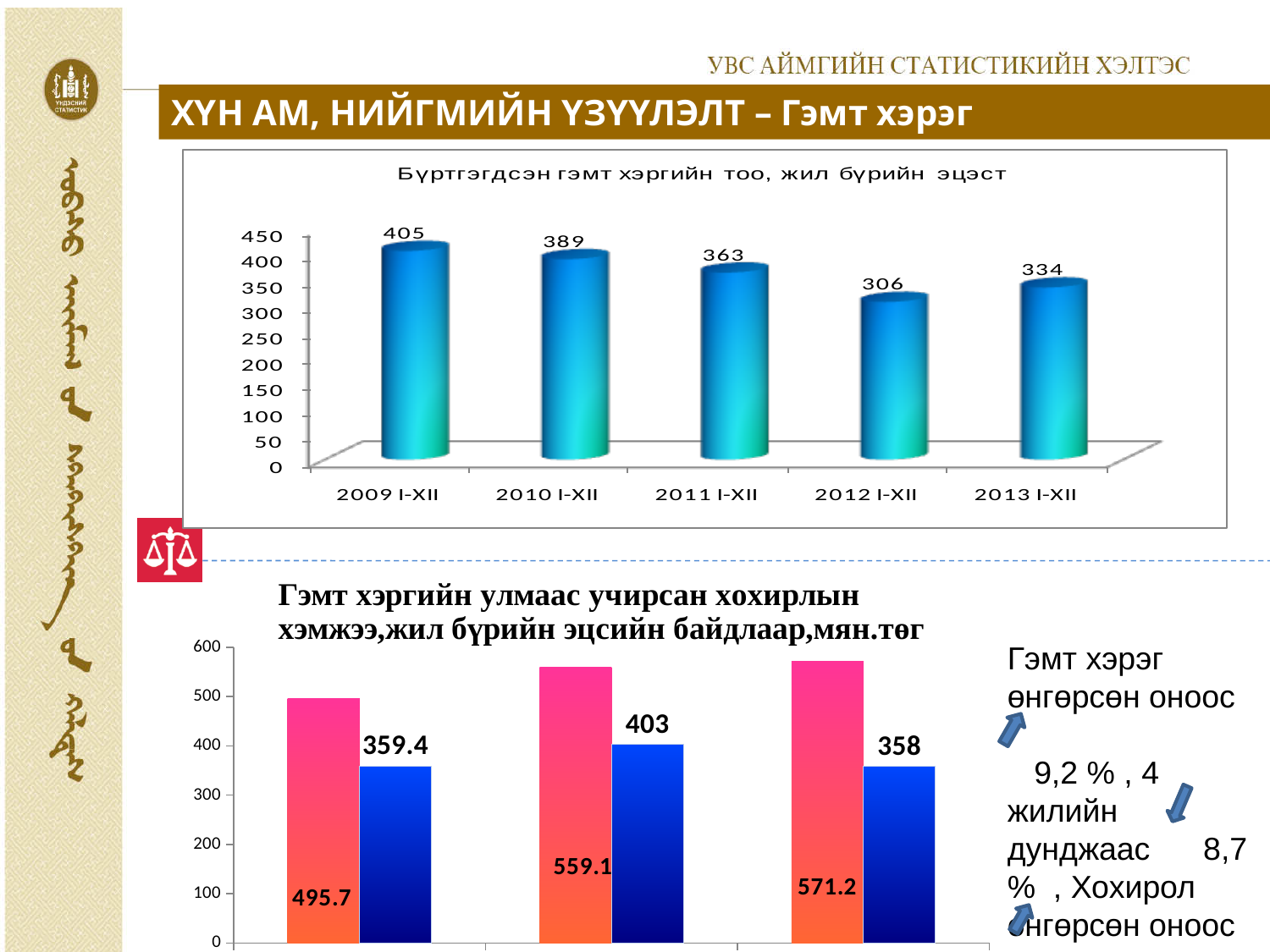
In the top chart 'Бүртгэгдсэн гэмт хэргийн тоо, жил бүрийн эцэст', what is the value for 2009 I-XII? 405 In the top chart 'Бүртгэгдсэн гэмт хэргийн тоо, жил бүрийн эцэст', which is larger: the value for 2013 I-XII or 2012 I-XII? 2013 I-XII In the bottom chart 'Гэмт хэргийн улмаас учирсан хохирлын хэмжээ', what is the value of the red bar in the first group from the left? 495.7 In the top chart 'Бүртгэгдсэн гэмт хэргийн тоо, жил бүрийн эцэст', how many years are shown on the x axis? 5 In the top chart 'Бүртгэгдсэн гэмт хэргийн тоо, жил бүрийн эцэст', what is the value for 2012 I-XII? 306 What kind of chart is the top chart 'Бүртгэгдсэн гэмт хэргийн тоо, жил бүрийн эцэст'? bar chart In the top chart 'Бүртгэгдсэн гэмт хэргийн тоо, жил бүрийн эцэст', which year has the highest value? 2009 I-XII In the bottom chart 'Гэмт хэргийн улмаас учирсан хохирлын хэмжээ', what is the value of the blue bar in the middle group? 403 In the top chart 'Бүртгэгдсэн гэмт хэргийн тоо, жил бүрийн эцэст', what is the difference between the values for 2010 I-XII and 2011 I-XII? 26 In the bottom chart 'Гэмт хэргийн улмаас учирсан хохирлын хэмжээ', what is the difference between the red and blue bars in the rightmost group? 213.2 In the top chart 'Бүртгэгдсэн гэмт хэргийн тоо, жил бүрийн эцэст', do the values rise or fall from 2009 I-XII to 2012 I-XII? fall In the top chart 'Бүртгэгдсэн гэмт хэргийн тоо, жил бүрийн эцэст', which year has the lowest value? 2012 I-XII